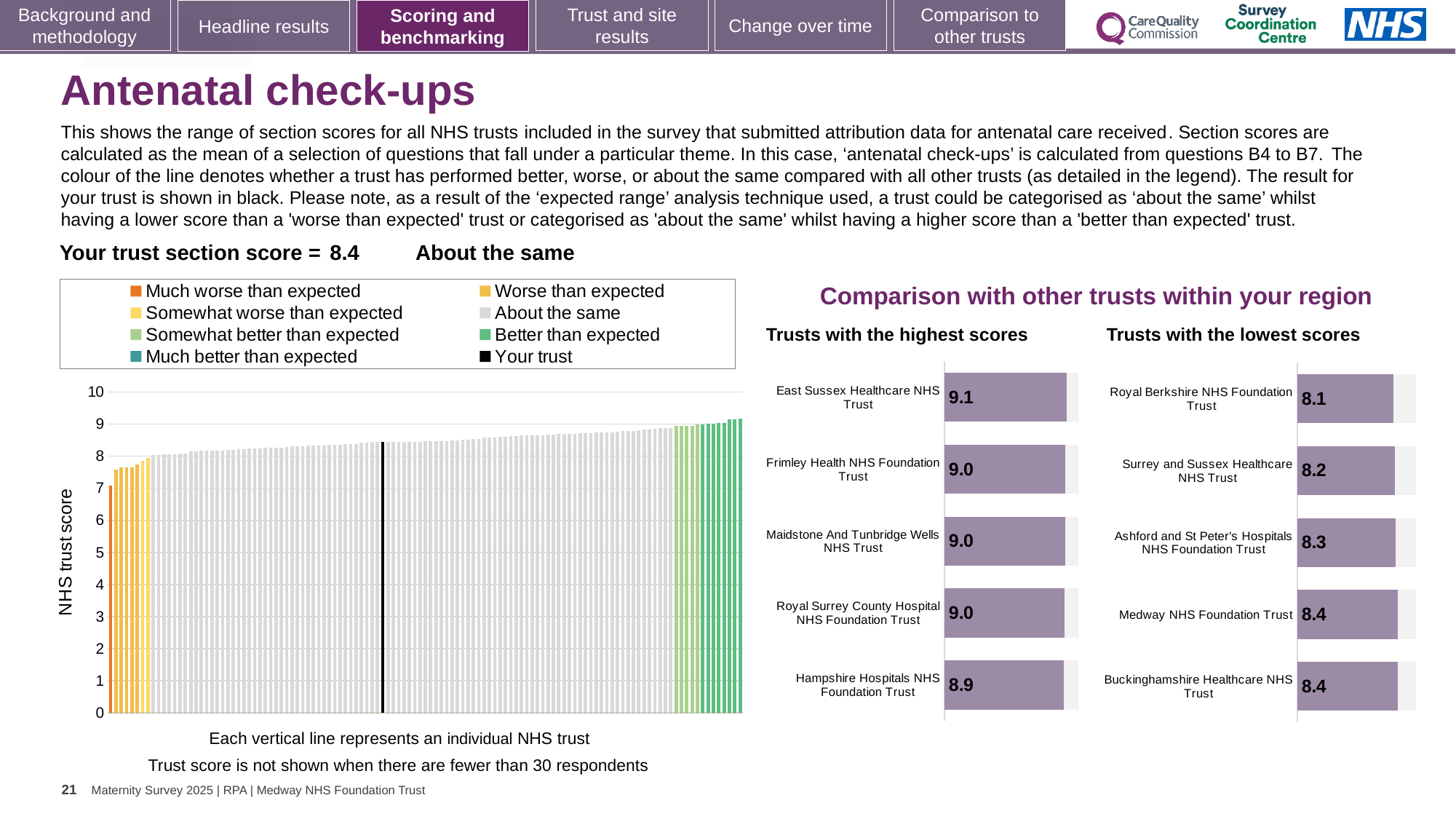
How many entries does the legend above the left-hand NHS trust score chart list? 8 In the 'Trusts with the lowest scores' chart, which has the higher score: Ashford and St Peter's Hospitals NHS Foundation Trust or Surrey and Sussex Healthcare NHS Trust? Ashford and St Peter's Hospitals NHS Foundation Trust How many trusts are shown in the 'Trusts with the lowest scores' chart? 5 In the 'Trusts with the highest scores' chart, what is the score for East Sussex Healthcare NHS Trust? 9.1 In the 'Trusts with the highest scores' chart, which trust has the lowest score? Hampshire Hospitals NHS Foundation Trust In the left-hand NHS trust score chart, do the bars rise or fall from left to right? rise What kind of chart is the large chart on the left showing NHS trust scores? bar chart In the 'Trusts with the highest scores' chart, what is the difference between the scores of East Sussex Healthcare NHS Trust and Hampshire Hospitals NHS Foundation Trust? 0.2 In the left-hand NHS trust score chart, is the value of the black 'Your trust' bar greater or less than 8? greater In the left-hand NHS trust score chart, is the value of the tallest bar greater or less than 10? less In the 'Trusts with the lowest scores' chart, what is the score for Medway NHS Foundation Trust? 8.4 In the 'Trusts with the lowest scores' chart, which trust has the lowest score? Royal Berkshire NHS Foundation Trust